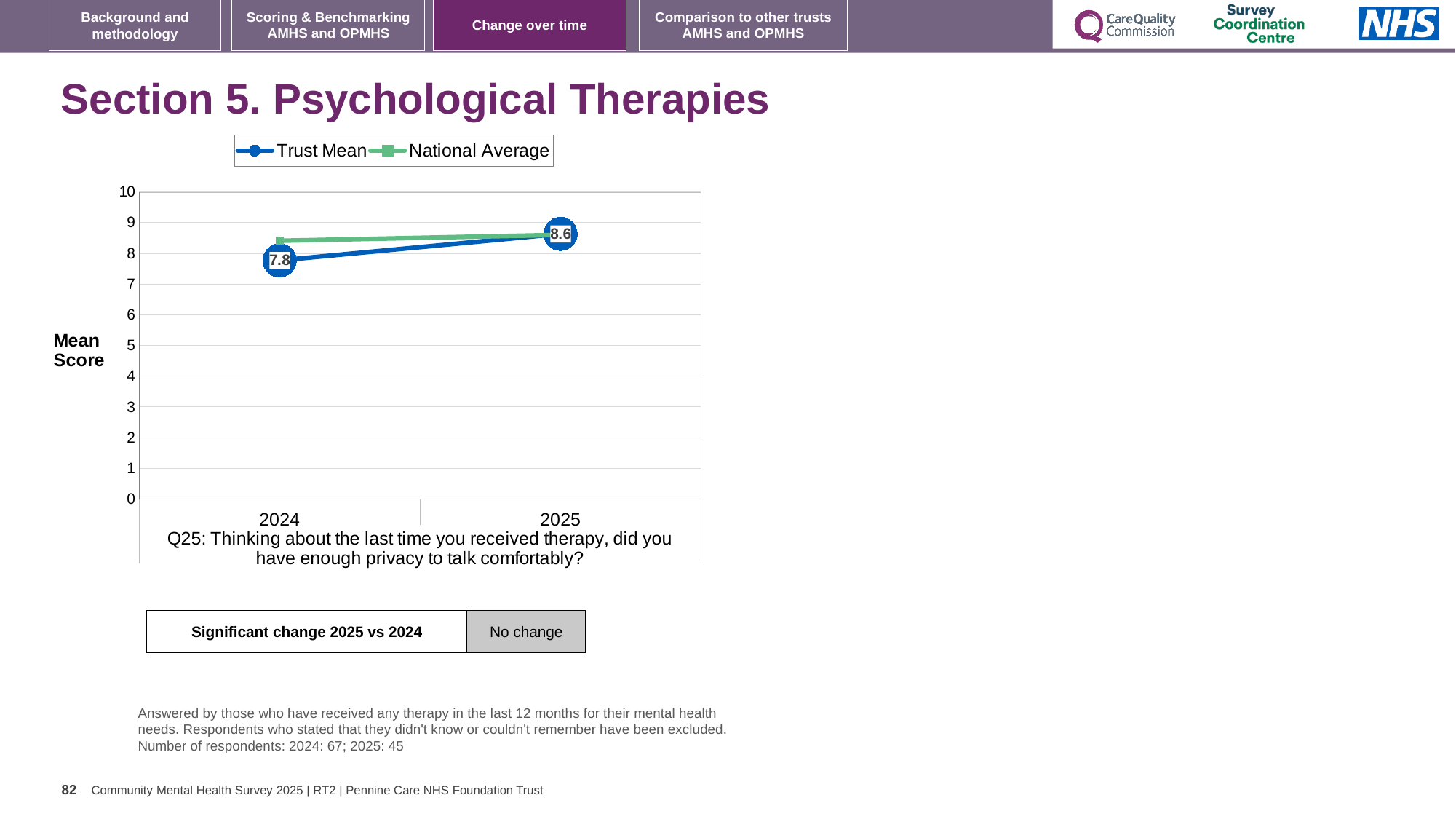
How many series does the legend list? 2 What kind of chart is shown on the slide? Line chart Is the National Average value for 2024 greater or less than 8? greater Does the Trust Mean rise or fall from 2024 to 2025? Rise What is the Trust Mean score for 2024? 7.8 In 2024, which is higher: the Trust Mean or the National Average? National Average How many years are plotted on the x axis? 2 What is the difference between the Trust Mean scores for 2025 and 2024? 0.8 In which year is the Trust Mean score lowest? 2024 What is the Trust Mean score for 2025? 8.6 In which year is the Trust Mean score highest? 2025 Is the National Average value for 2025 greater or less than 9? less